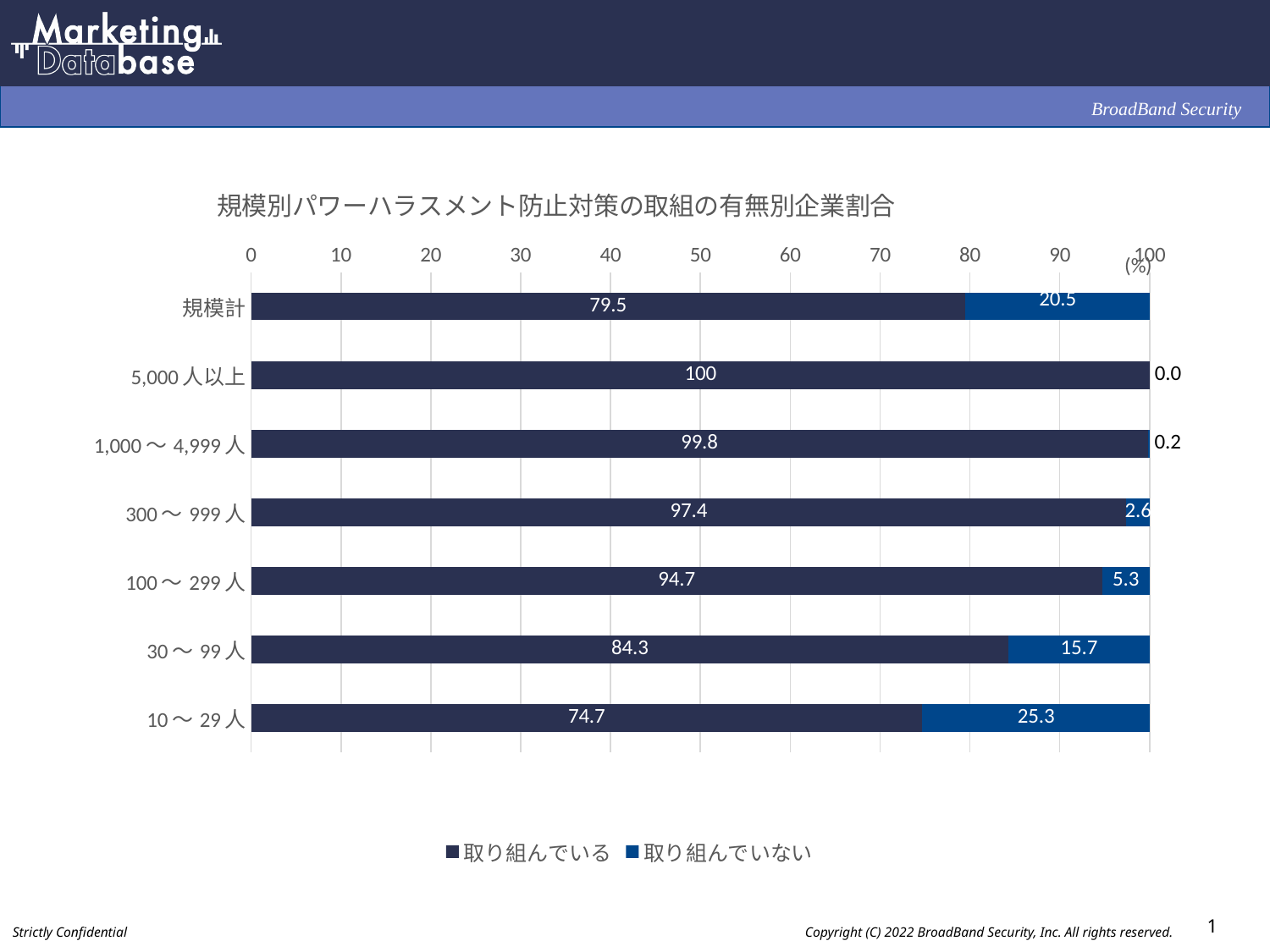
How many series does the legend list? 2 What is the value of 取り組んでいる for 規模計? 79.5 What is the total of the stacked bar for 規模計? 100 Which category has the highest value for 取り組んでいない? 10～29人 How many categories are shown on the vertical axis? 7 Which is larger, the 取り組んでいない value for 100～299人 or for 30～99人? 30～99人 What is the title of the chart? 規模別パワーハラスメント防止対策の取組の有無別企業割合 What is the value of 取り組んでいない for 10～29人? 25.3 What is the value of 取り組んでいる for 300～999人? 97.4 What is the difference between the 取り組んでいる values for 30～99人 and 10～29人? 9.6 Which category has the lowest value for 取り組んでいる? 10～29人 What type of chart is shown on the slide? Stacked bar chart